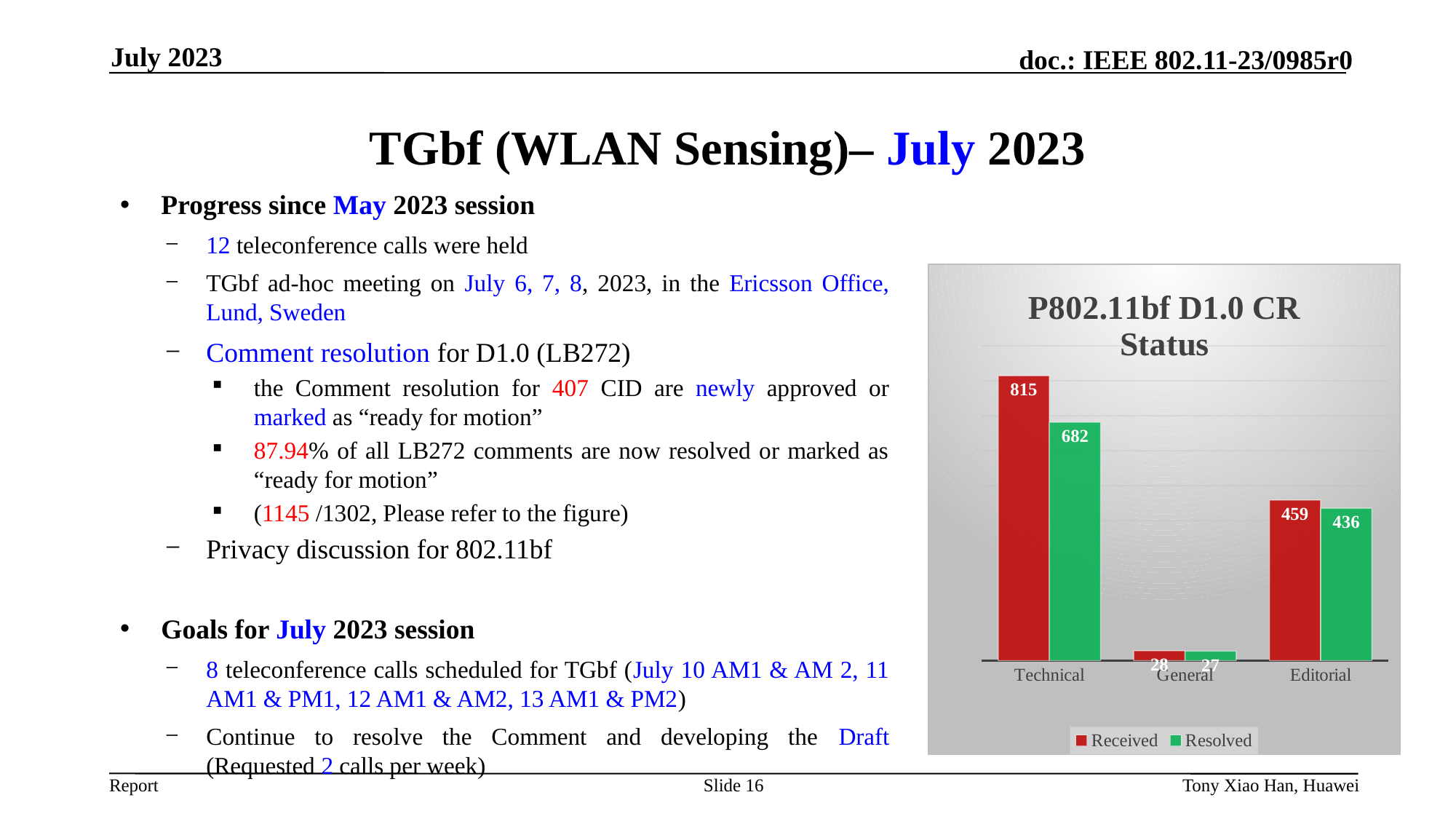
What is the Resolved value for the Editorial category? 436 Which is larger for the Editorial category, Received or Resolved? Received What is the difference between Received and Resolved for the Technical category? 133 What is the Received value for the General category? 28 How many categories are shown on the x axis of the chart? 3 What is the difference between Received and Resolved for the Editorial category? 23 What kind of chart is shown on the slide? Bar chart Which category has the highest Received value? Technical Which category has the lowest Resolved value? General What is the title of the chart? P802.11bf D1.0 CR Status What is the Received value for the Technical category? 815 How many series does the chart legend list? 2